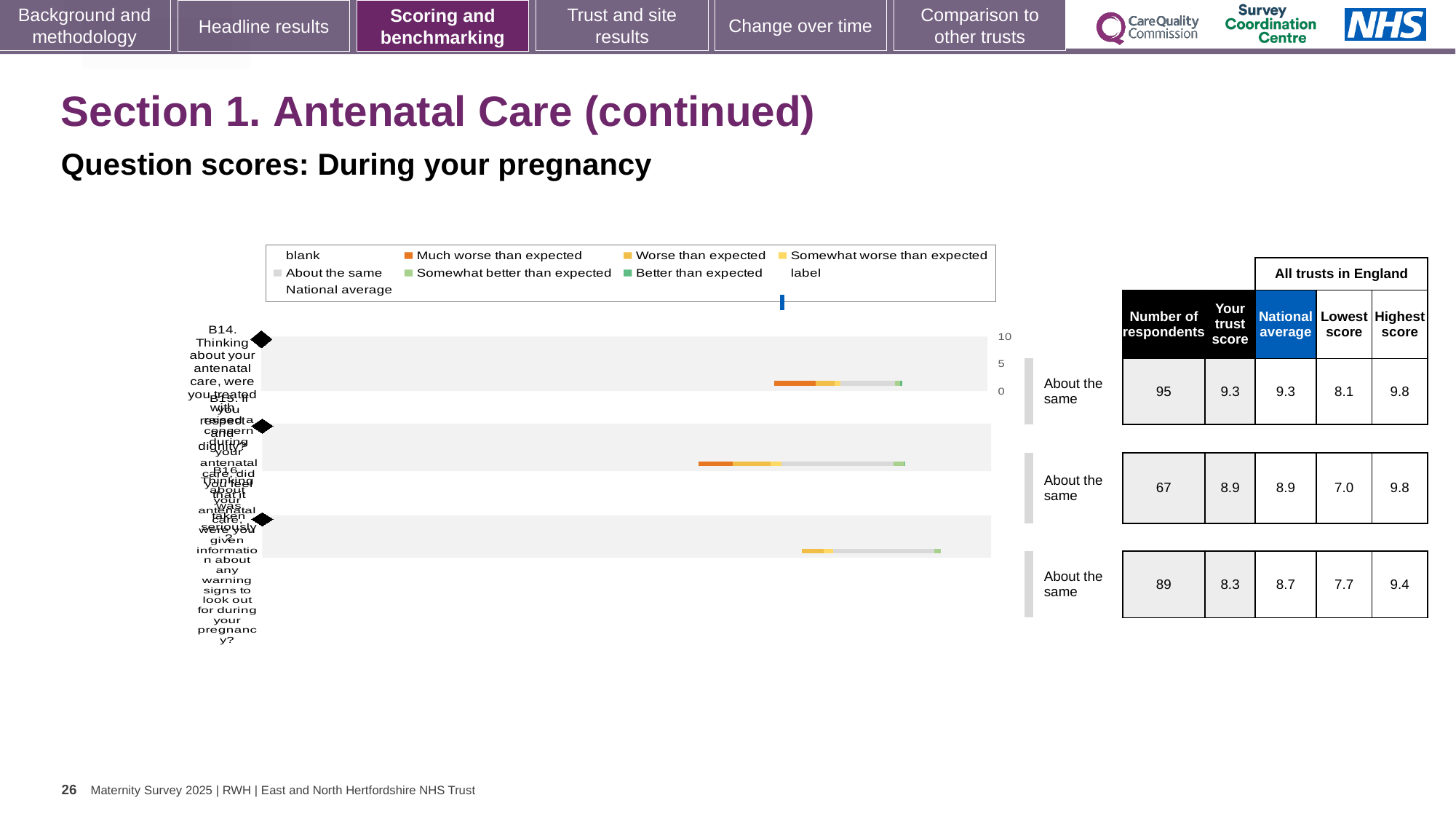
Which legend entry is shown in dark green? Better than expected How many bars (questions) are plotted in the chart? 3 What is the highest tick value shown on the chart's axis? 10 What colour does the legend use for 'Much worse than expected'? orange What benchmark category is shown beside each bar in the chart? About the same What kind of chart is shown on the slide? bar chart